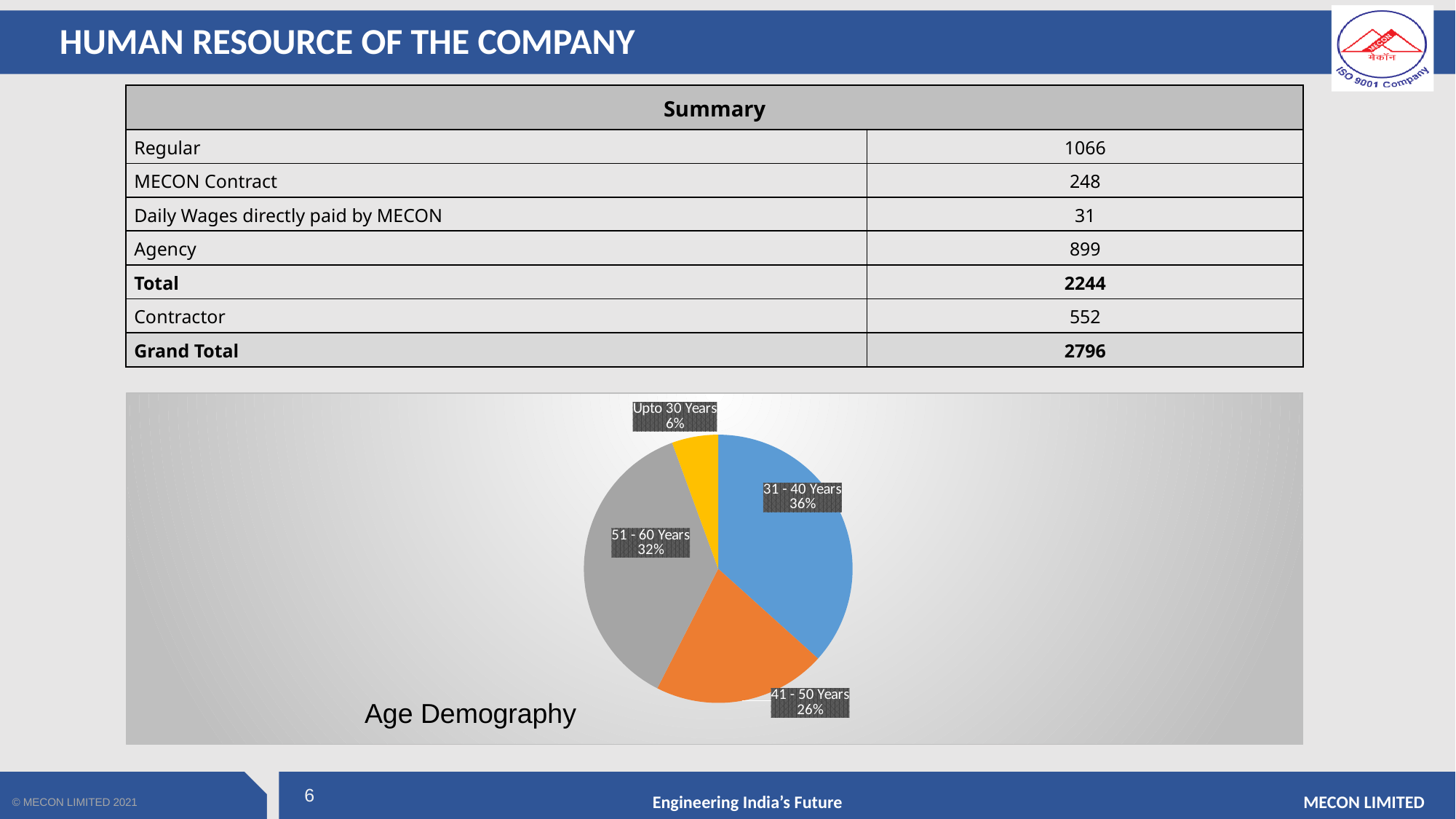
What share of the Age Demography pie is the 31 - 40 Years slice? 36% How many age groups are shown in the Age Demography pie chart? 4 In the Age Demography chart, which slice is larger: 51 - 60 Years or 41 - 50 Years? 51 - 60 Years What type of chart is the Age Demography chart? pie chart What share of the Age Demography pie is the 51 - 60 Years slice? 32% What share of the Age Demography pie is the Upto 30 Years slice? 6% In the Age Demography chart, what is the difference in percentage points between the 31 - 40 Years and 41 - 50 Years slices? 10 Which age group has the smallest share in the Age Demography chart? Upto 30 Years What is the title of the pie chart on the slide? Age Demography What colour is the 41 - 50 Years slice in the Age Demography chart? orange Which age group has the largest share in the Age Demography chart? 31 - 40 Years